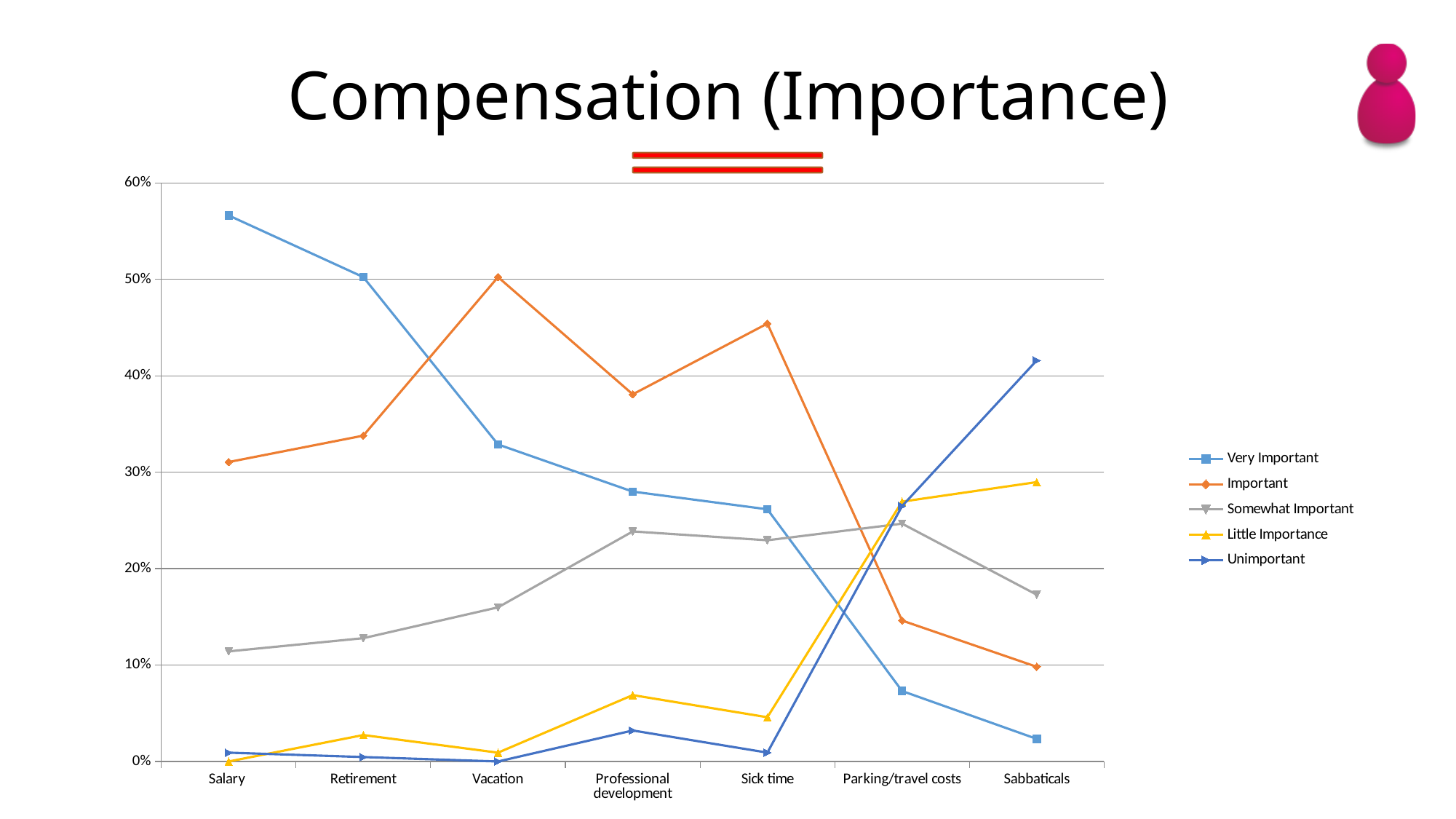
Does the Very Important series rise or fall from Salary to Sabbaticals? fall For which category is the Very Important series lowest? Sabbaticals For which category is the Unimportant series highest? Sabbaticals How many series does the legend list? 5 How many compensation categories are plotted along the x axis? 7 For Vacation, which is larger: Important or Very Important? Important For which category is the Important series highest? Vacation What kind of chart is shown on the slide? line chart For Salary, which is larger: Very Important or Important? Very Important Is the Very Important value for Salary greater or less than 50%? greater Is the Important value for Sick time greater or less than 40%? greater For which category is the Very Important series highest? Salary